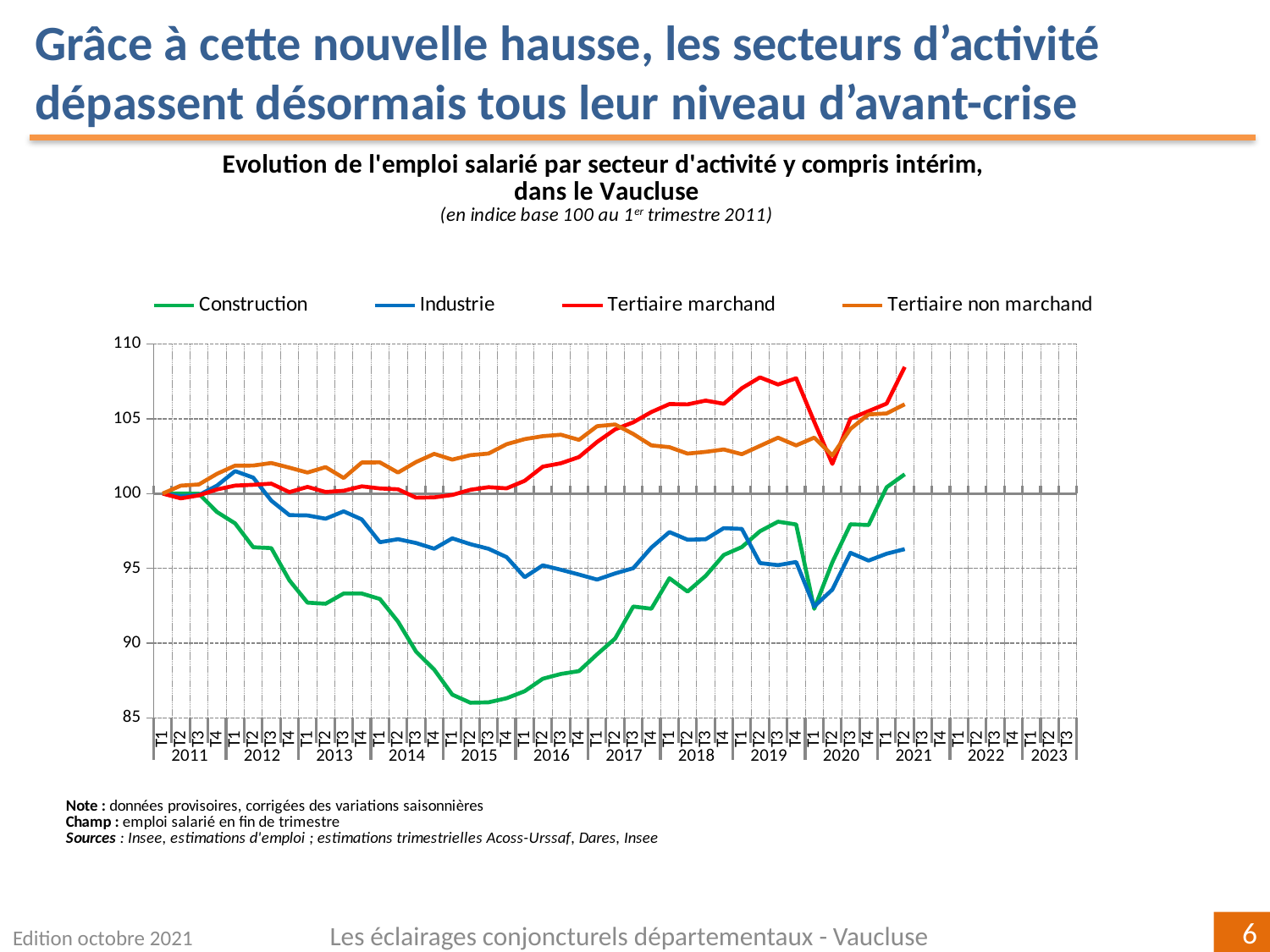
Which series is shown in green in the legend? Construction What kind of chart is shown on the slide? line chart Which series has the highest value at T2 2019? Tertiaire marchand Which series has the lowest value at T1 2015? Construction At T2 2021, which is higher: Tertiaire marchand or Construction? Tertiaire marchand Is the value for Construction at T1 2015 greater or less than 90? less What is the index value of all series at T1 2011, the base quarter? 100 Is the value for Industrie at T1 2020 greater or less than 95? less Is the value for Tertiaire marchand at T2 2021 greater or less than 105? greater How many series does the legend list? 4 Does the Construction series rise or fall between T1 2011 and T1 2015? fall